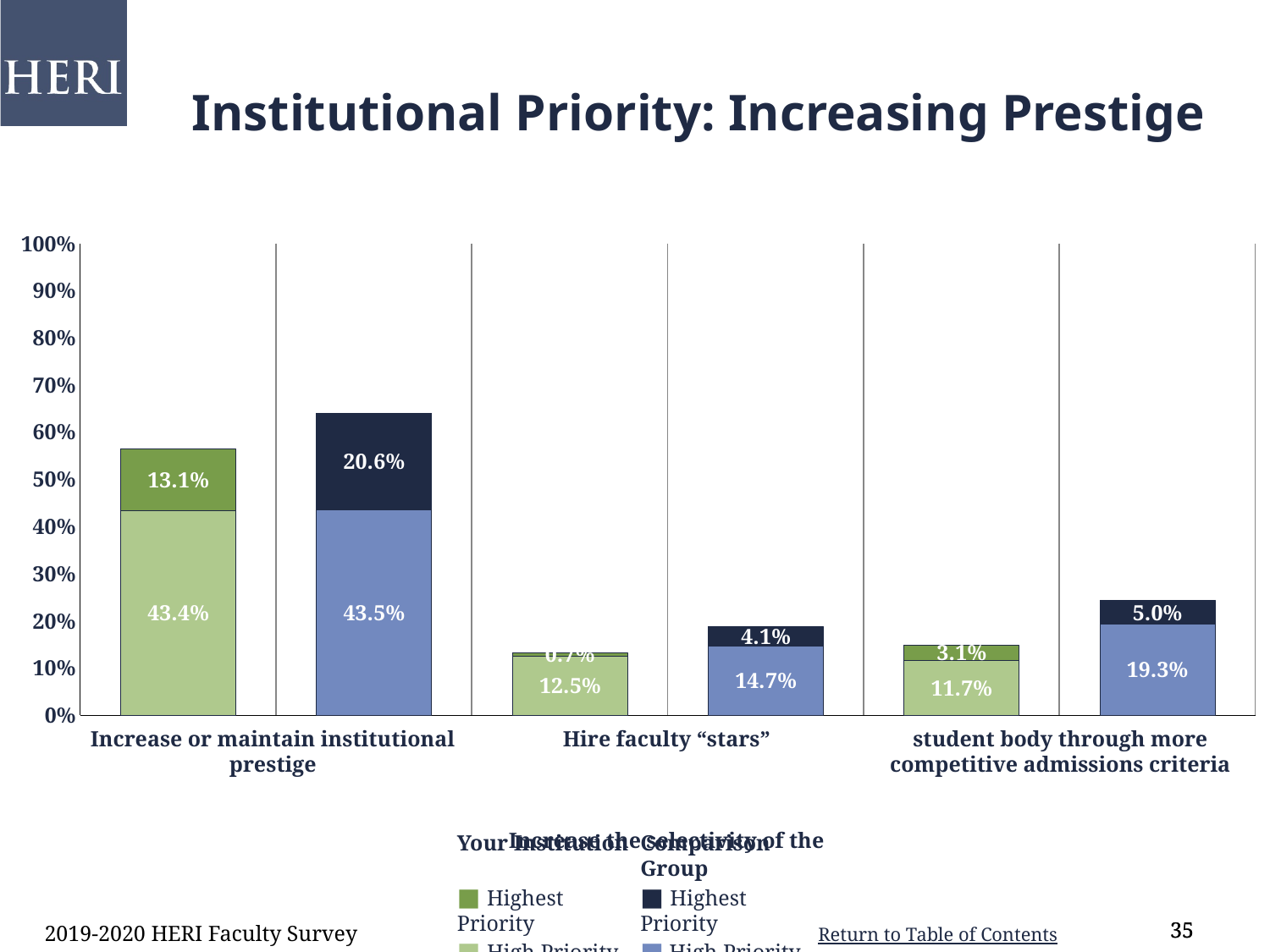
Which category has the tallest stacked bar for the Comparison Group? Increase or maintain institutional prestige What is the difference between the Comparison Group's and Your Institution's Highest Priority values for "Increase or maintain institutional prestige"? 7.5% What kind of chart is shown on the slide? stacked bar chart What is the Comparison Group's High Priority value for "Hire faculty 'stars'"? 14.7% What is the Your Institution High Priority value for "Increase or maintain institutional prestige"? 43.4% What is the Comparison Group's High Priority value for the category about the student body and more competitive admissions criteria? 19.3% Which is larger: the Comparison Group's Highest Priority value for "Hire faculty 'stars'" or for the student body admissions criteria category? student body admissions criteria category (5.0%) What is the Comparison Group's Highest Priority value for "Increase or maintain institutional prestige"? 20.6% What is the Your Institution Highest Priority value for the category about the student body and more competitive admissions criteria? 3.1% What is the total of the Comparison Group's stacked bar for "Increase or maintain institutional prestige"? 64.1% How many categories are shown on the x axis? 3 What is the total of the Your Institution stacked bar for "Hire faculty 'stars'"? 13.2%